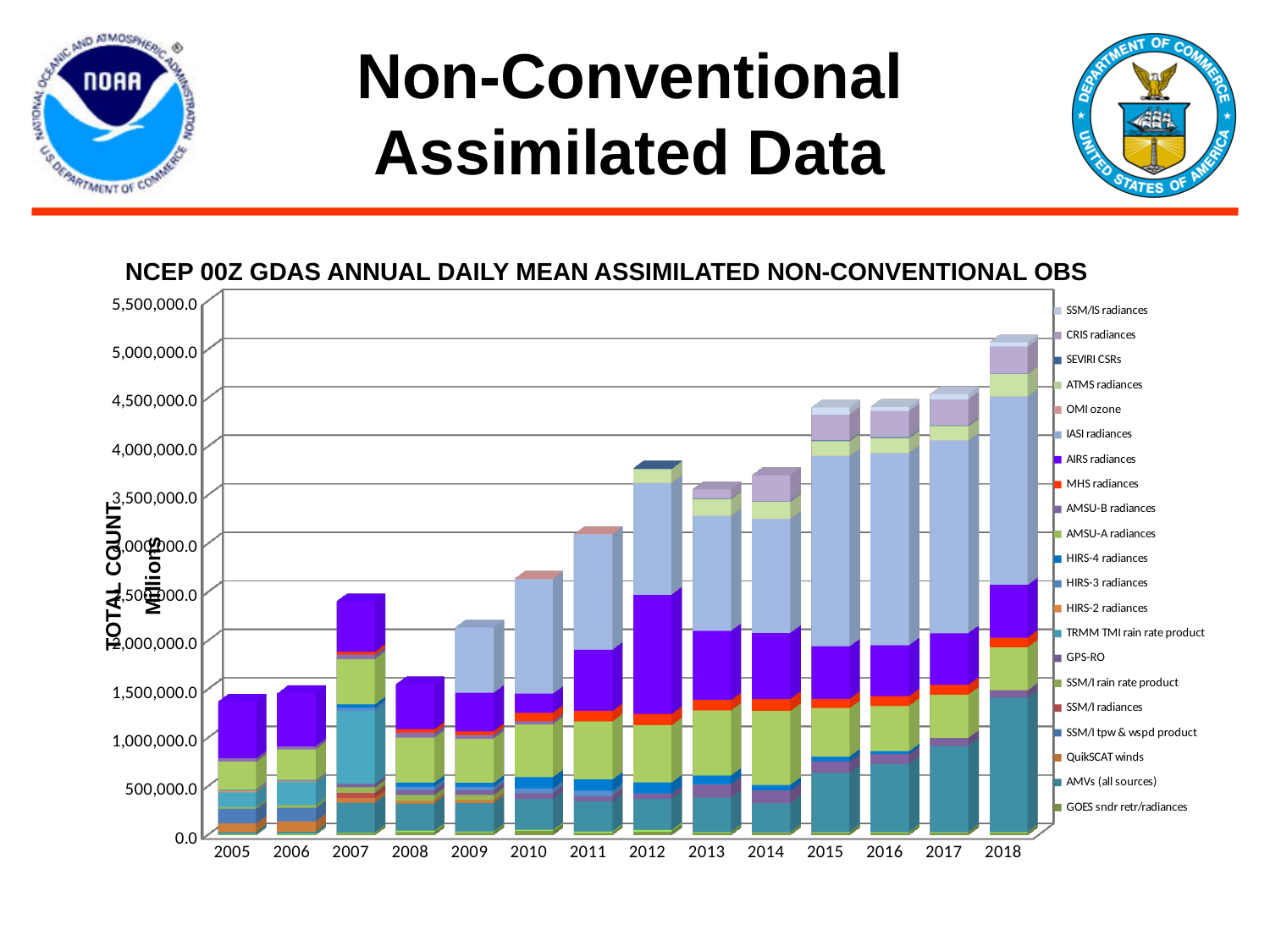
Is the total for 2010 greater or less than 2,500,000.0? greater Is the total for 2012 greater or less than 3,500,000.0? greater Is the total for 2005 greater or less than 1,500,000.0? less Which year has the highest total assimilated non-conventional observations? 2018 What is the title of the chart? NCEP 00Z GDAS ANNUAL DAILY MEAN ASSIMILATED NON-CONVENTIONAL OBS Which year has the larger total, 2014 or 2015? 2015 Do the total bar heights generally rise or fall from 2005 to 2018? Rise How many series does the chart's legend list? 21 What kind of chart is shown on the slide? Stacked bar chart Which year has the larger total, 2007 or 2008? 2007 How many years are shown along the x axis of the chart? 14